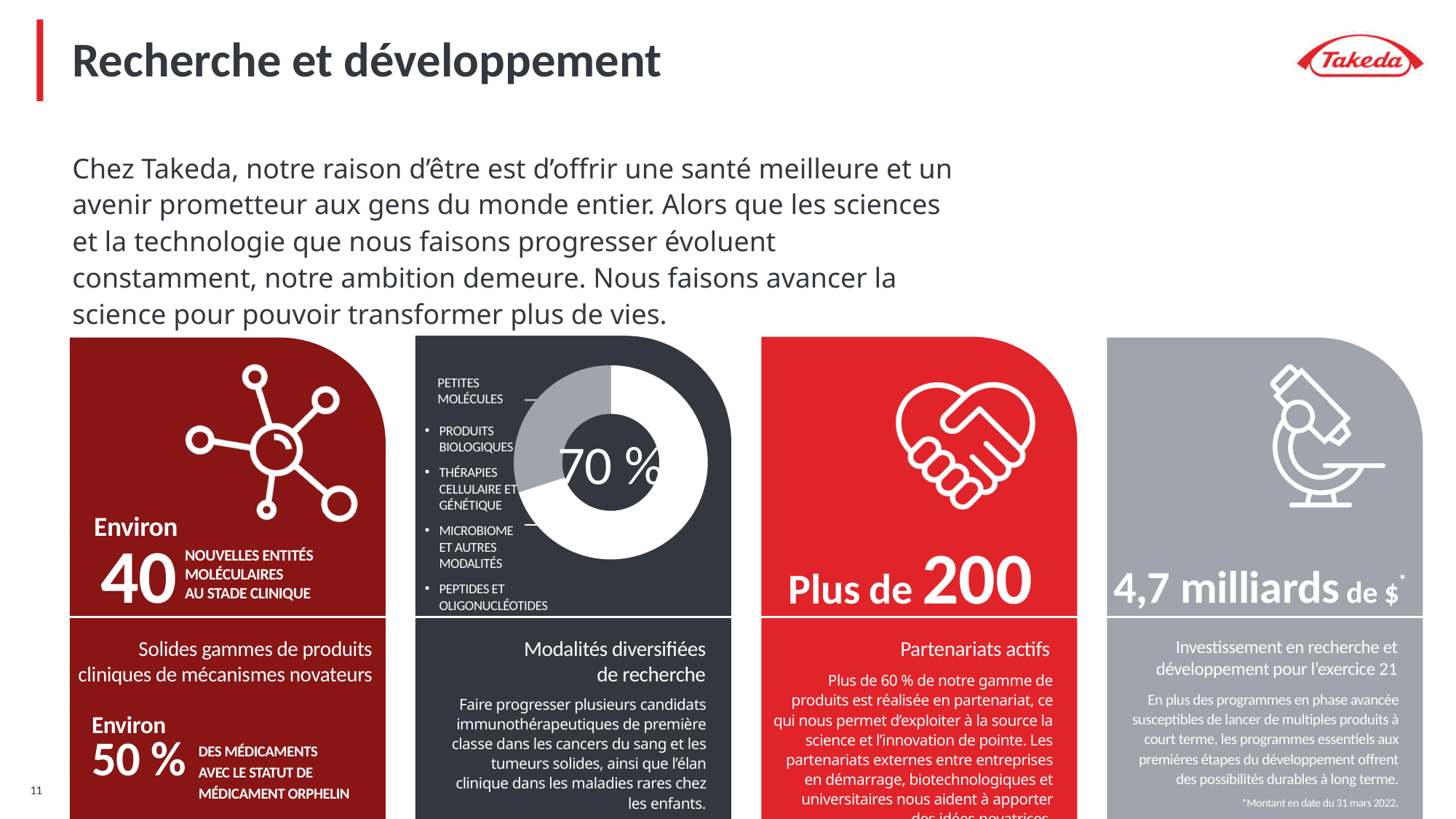
Is the white slice of the donut chart greater or less than 50 %? greater What share of the donut chart does the white slice represent? 70 % Which label is connected by a leader line to the grey slice of the donut chart? PETITES MOLÉCULES What is the title of the panel containing the donut chart? Modalités diversifiées de recherche What percentage is printed in the centre of the donut chart? 70 % What kind of chart is shown in the 'Modalités diversifiées de recherche' panel? Pie (donut) chart How many slices does the donut chart have? 2 Is the grey slice of the donut chart greater or less than 50 %? less Which slice of the donut chart is larger, the white one or the grey one? The white one